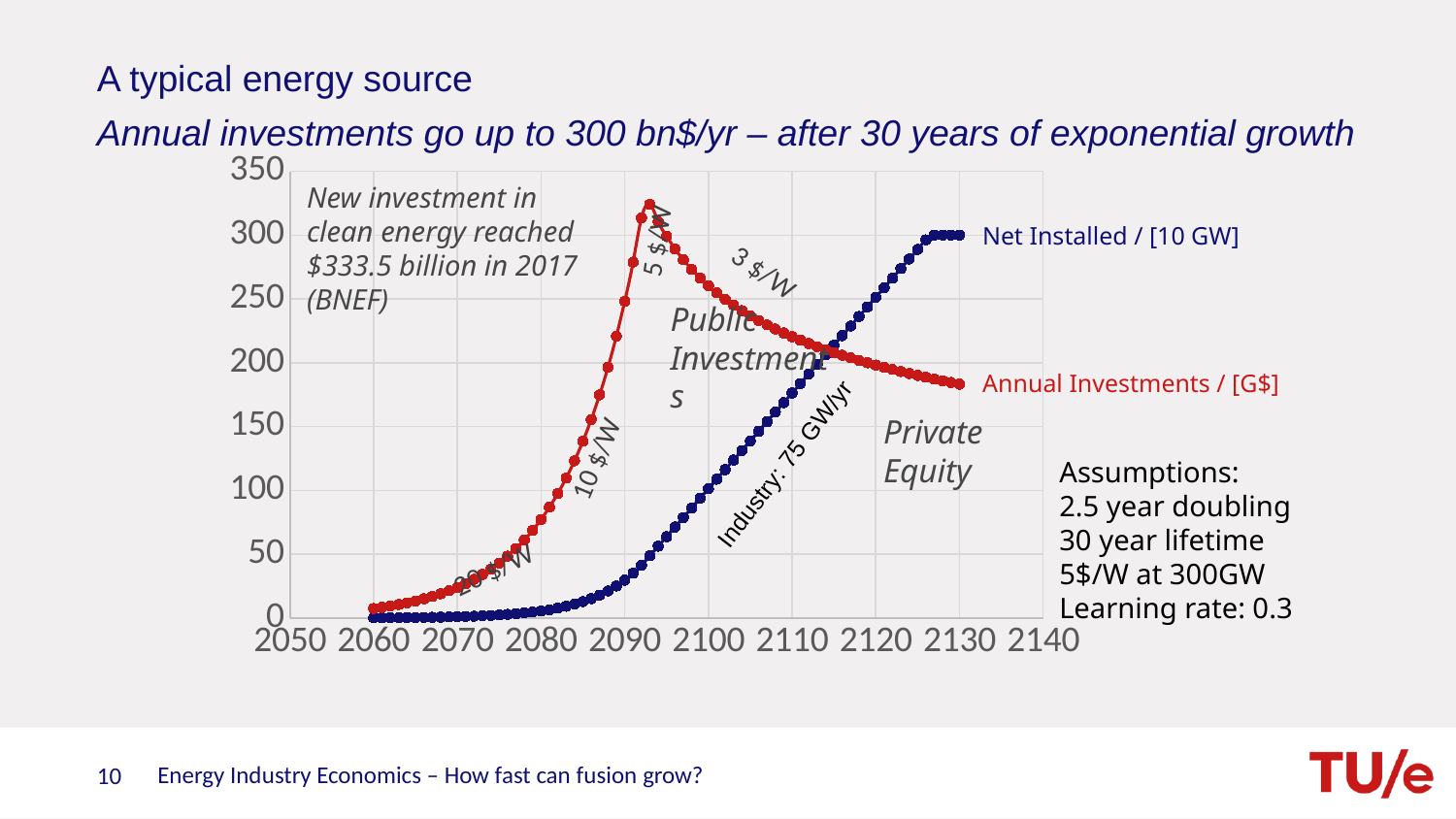
Is the value of Annual Investments at 2130 greater or less than 200? less At 2130, which series has the higher value, Net Installed or Annual Investments? Net Installed Which series is drawn in red? Annual Investments / [G$] Is the value of Annual Investments at 2080 greater or less than 100? less At 2090, which series has the higher value, Net Installed or Annual Investments? Annual Investments Which series is drawn in blue? Net Installed / [10 GW] Is the value of Net Installed at 2080 greater or less than 50? less How many data series are plotted on the chart? 2 Does the Net Installed series rise or fall as the years increase along the x axis? rise What kind of chart is shown on the slide? line chart